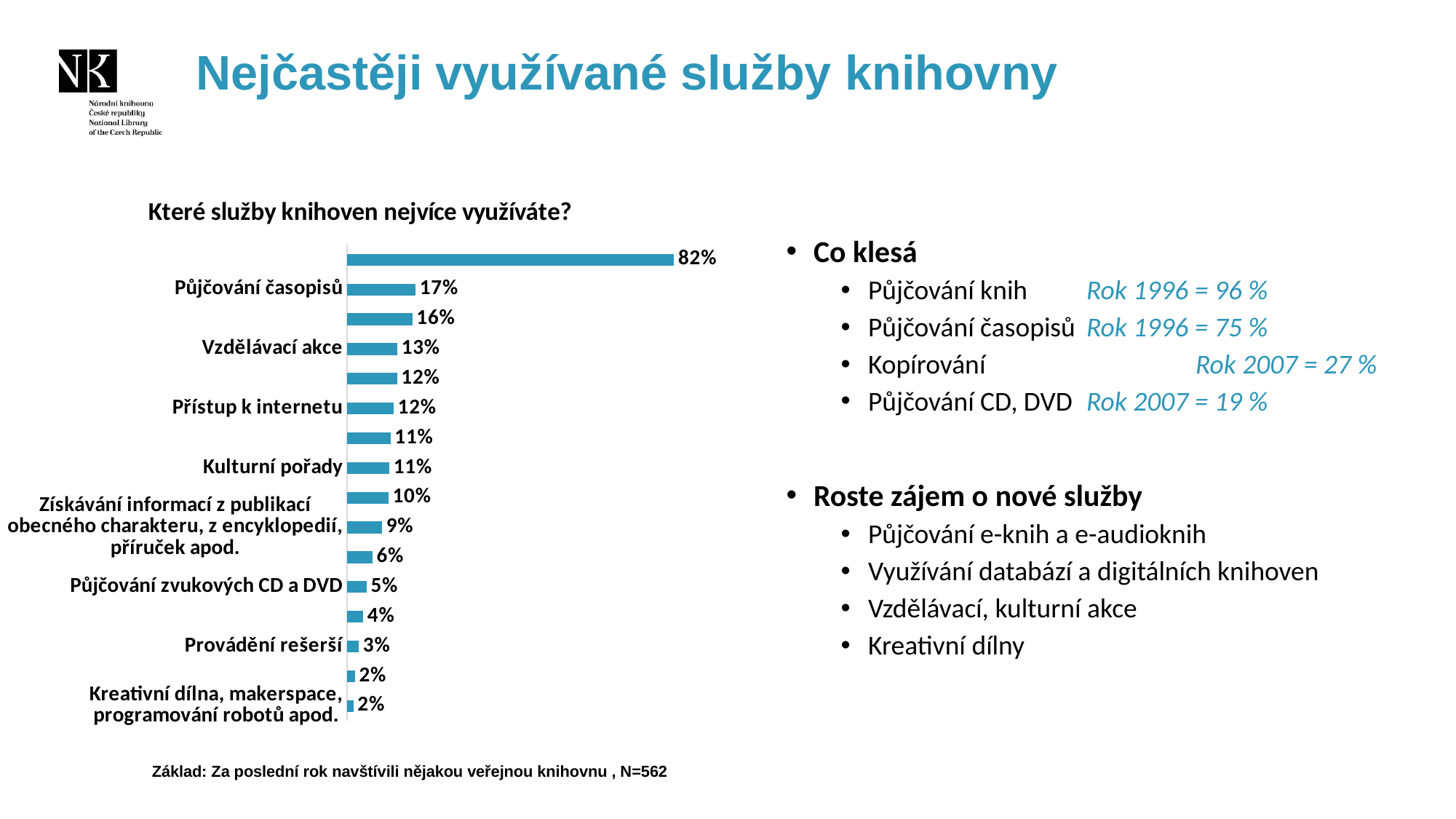
What is the difference between the values for Půjčování časopisů and Vzdělávací akce? 4 percentage points What is the value for Přístup k internetu in the chart? 12% How many bars are plotted in the chart? 16 What is the value for Půjčování časopisů in the chart? 17% What is the value for Kulturní pořady in the chart? 11% What is the value for Půjčování zvukových CD a DVD in the chart? 5% What is the title of the chart? Které služby knihoven nejvíce využíváte? What is the value for Vzdělávací akce in the chart? 13% What kind of chart is shown on the slide? Bar chart What is the highest value shown in the chart? 82% What is the value for Provádění rešerší in the chart? 3% Which has a larger value, Kulturní pořady or Půjčování zvukových CD a DVD? Kulturní pořady